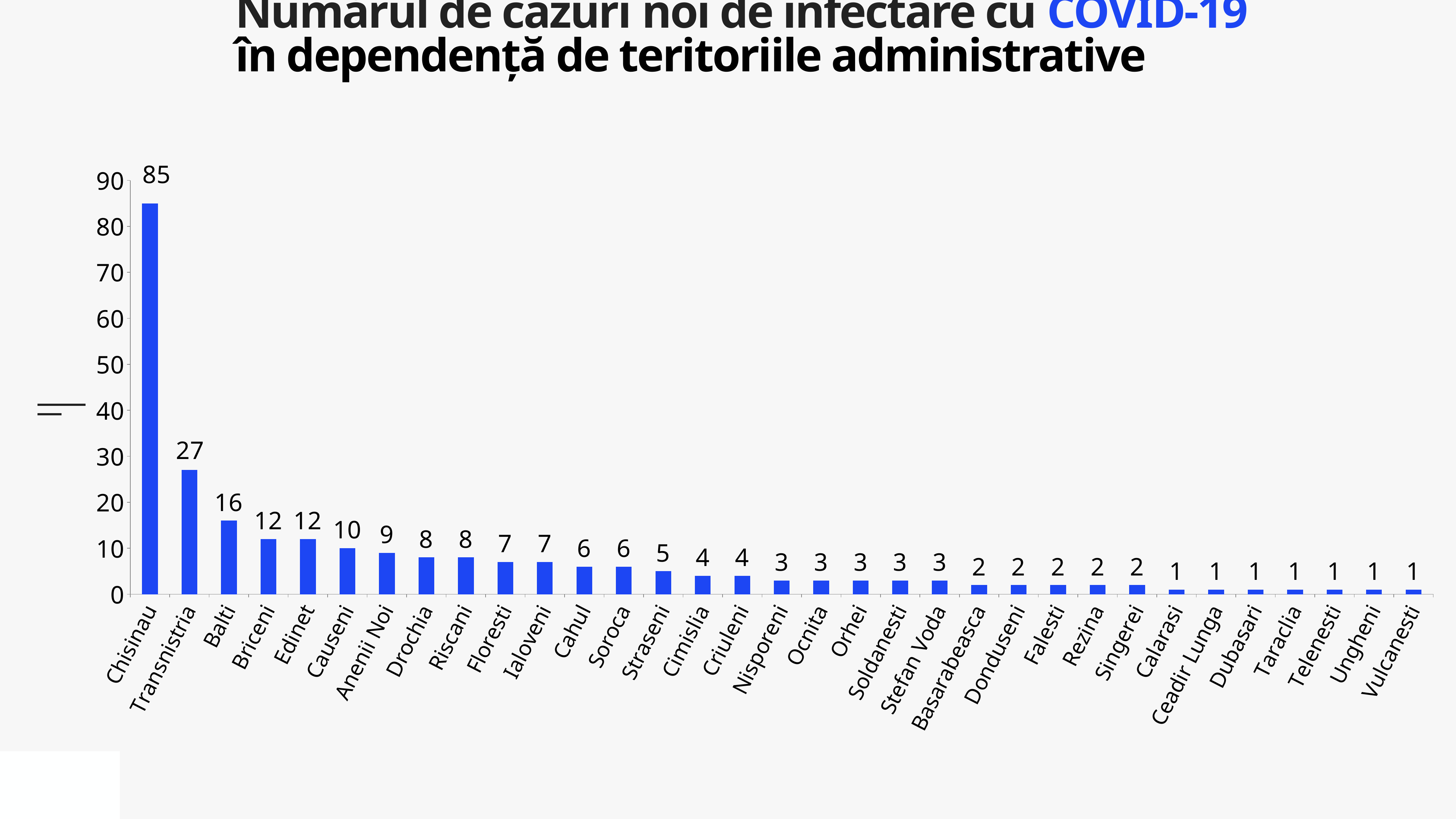
What is the value for Chisinau? 85 What kind of chart is shown on the slide? bar chart What is the difference between the values for Balti and Briceni? 4 What is the value for Balti? 16 How many categories are shown on the x axis? 33 What is the value for Transnistria? 27 Is the value for Transnistria greater or less than 30? less Which is larger, the value for Drochia or the value for Cahul? Drochia What is the difference between the values for Chisinau and Transnistria? 58 What is the value for Causeni? 10 Which category has the highest value? Chisinau What is the value for Straseni? 5